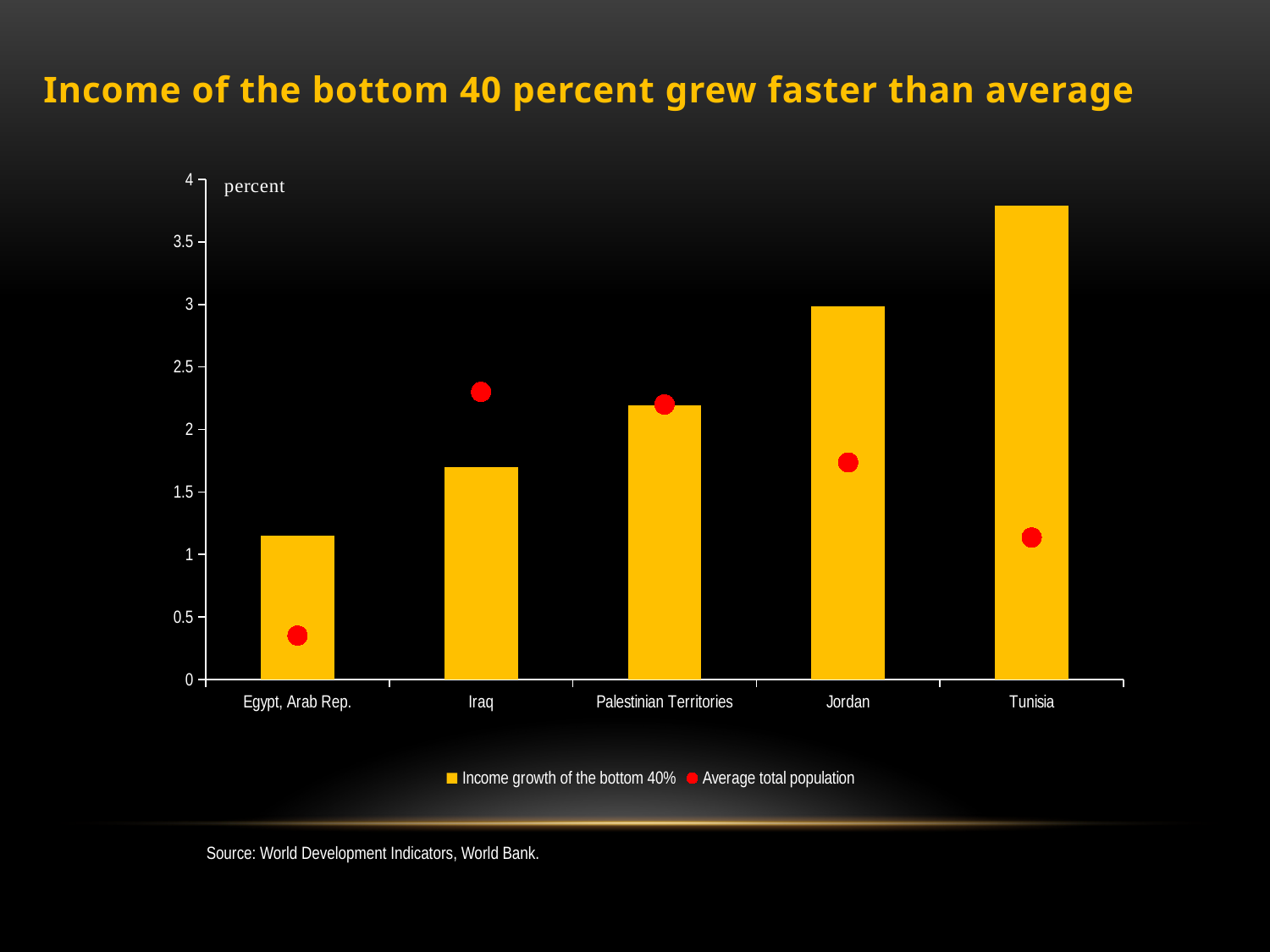
Is the average total population value for Iraq greater or less than 2? greater How many countries or territories are shown on the x axis? 5 Is the average total population value for Egypt, Arab Rep. greater or less than 0.5? less How many series does the legend list? 2 Which country has the lowest average total population income growth (red marker)? Egypt, Arab Rep. Which country has the lowest income growth of the bottom 40%? Egypt, Arab Rep. For Jordan, which is larger: income growth of the bottom 40% or average total population? Income growth of the bottom 40% Which country has the highest income growth of the bottom 40%? Tunisia Is the income growth of the bottom 40% for Tunisia greater or less than 3.5? greater What is the title of the slide? Income of the bottom 40 percent grew faster than average Do the bars for income growth of the bottom 40% rise or fall from left to right along the x axis? Rise What kind of chart is shown on the slide? A bar chart with overlaid markers (combination chart)